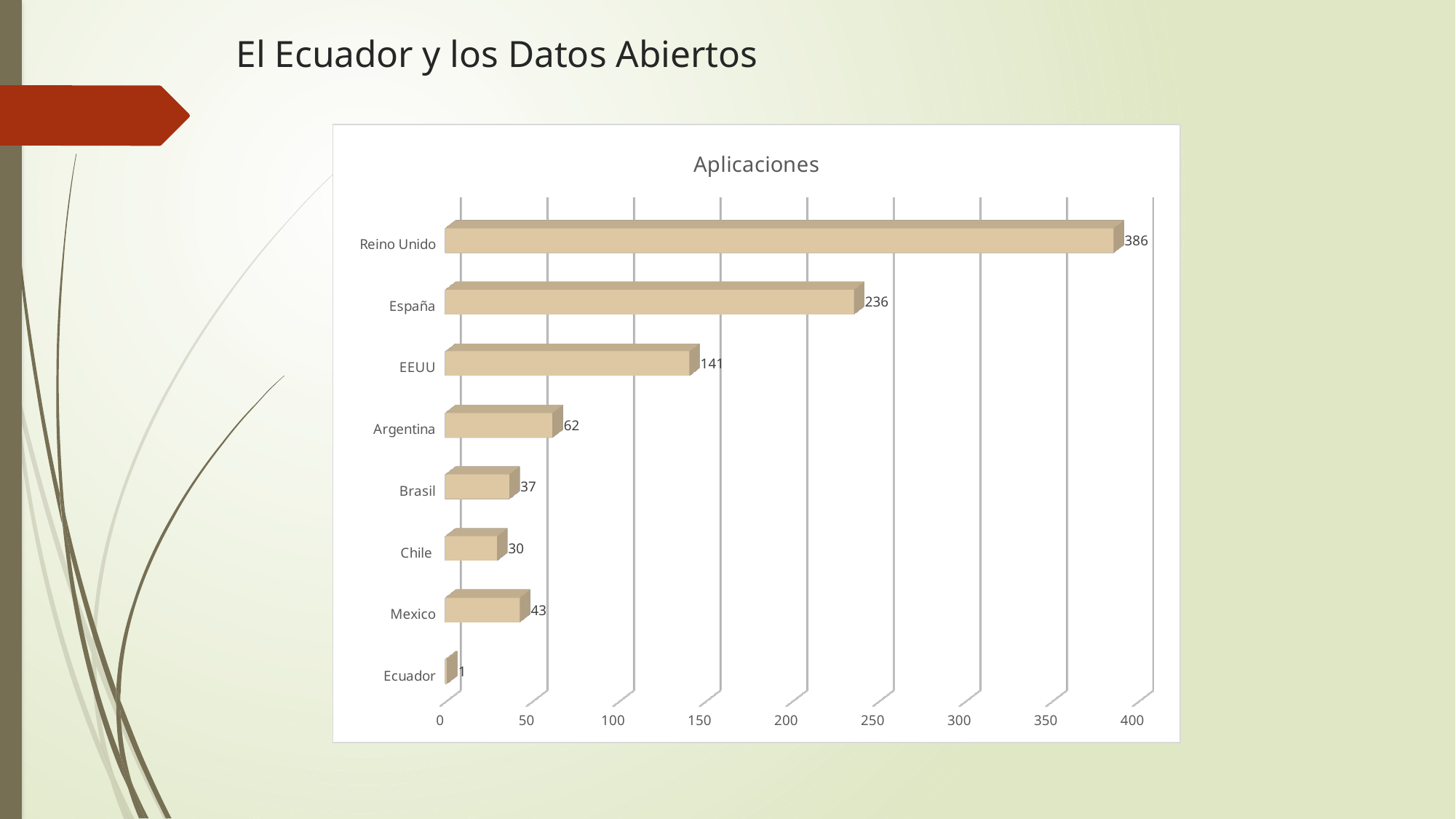
What is the value for EEUU? 141 How many categories are shown in the chart? 8 What is the value for Mexico? 43 What is the title of the chart? Aplicaciones What kind of chart is shown on the slide? bar chart Which is larger, the value for Mexico or the value for Chile? Mexico Which category has the lowest value? Ecuador Is the value for España greater or less than 200? greater What is the difference between the values for España and EEUU? 95 Which category has the highest value? Reino Unido What is the difference between the values for Argentina and Brasil? 25 What is the value for Reino Unido? 386